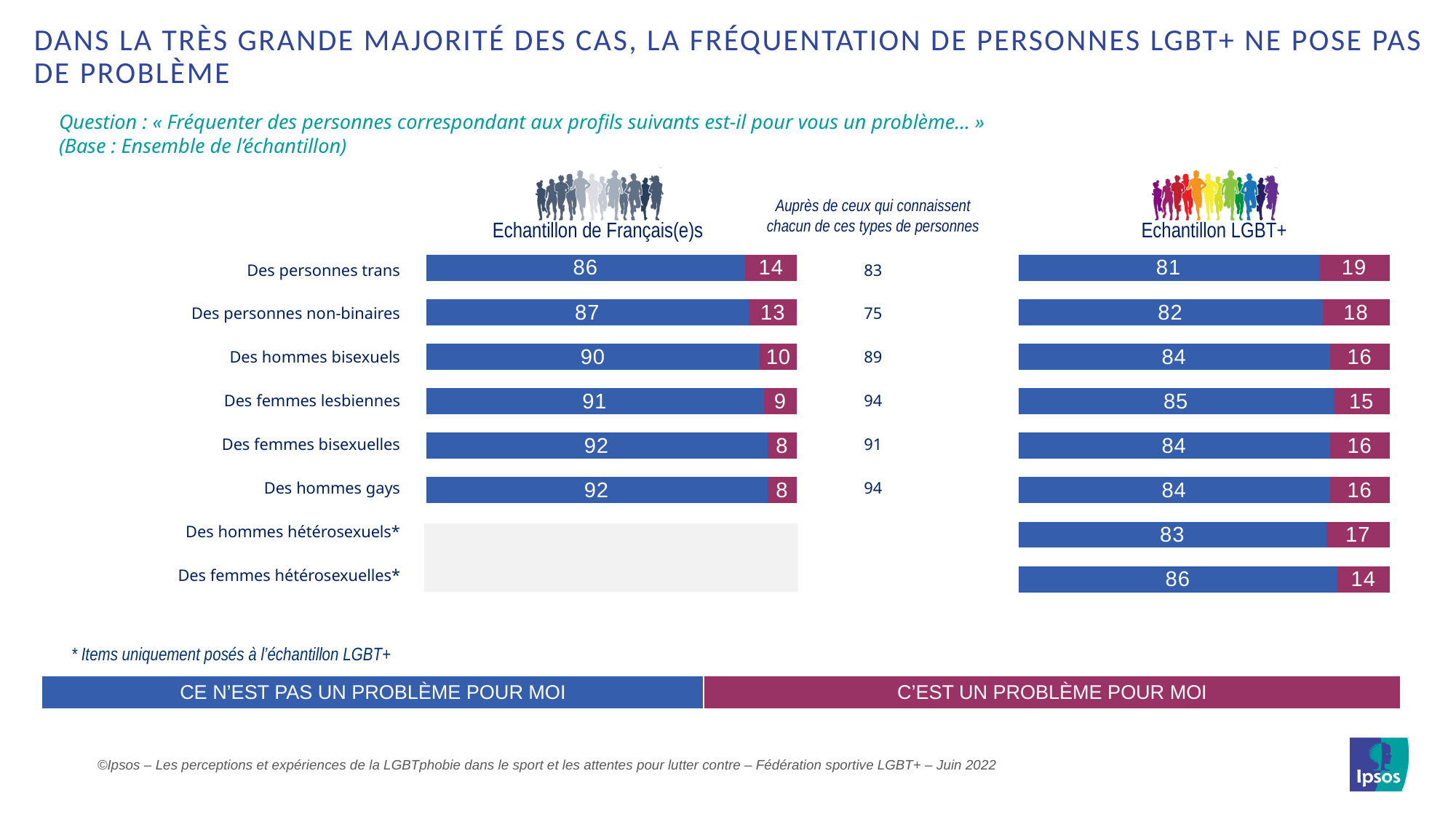
In the column 'Auprès de ceux qui connaissent chacun de ces types de personnes', what is the value for 'Des personnes non-binaires'? 75 In the 'Echantillon LGBT+' chart, what is the 'C'est un problème pour moi' value for 'Des personnes non-binaires'? 18 In the 'Echantillon de Français(e)s' chart, which category has the highest 'C'est un problème pour moi' value? Des personnes trans In the 'Echantillon LGBT+' chart, is the 'Ce n'est pas un problème pour moi' value larger for 'Des femmes hétérosexuelles*' or for 'Des hommes hétérosexuels*'? Des femmes hétérosexuelles* In the 'Echantillon de Français(e)s' chart, what is the difference between the 'Ce n'est pas un problème pour moi' values for 'Des hommes gays' and 'Des personnes trans'? 6 How many categories have bars in the 'Echantillon de Français(e)s' chart? 6 How many categories have bars in the 'Echantillon LGBT+' chart? 8 In the 'Echantillon LGBT+' chart, which category has the lowest 'Ce n'est pas un problème pour moi' value? Des personnes trans In the 'Echantillon LGBT+' chart, what is the total of the two segments for 'Des femmes lesbiennes'? 100 Which colour represents 'C'est un problème pour moi' in the charts? Magenta/purple-red What type of chart is used for the 'Echantillon LGBT+' data? Stacked bar chart In the 'Echantillon de Français(e)s' chart, what percentage say frequenting 'Des personnes trans' is not a problem for them? 86